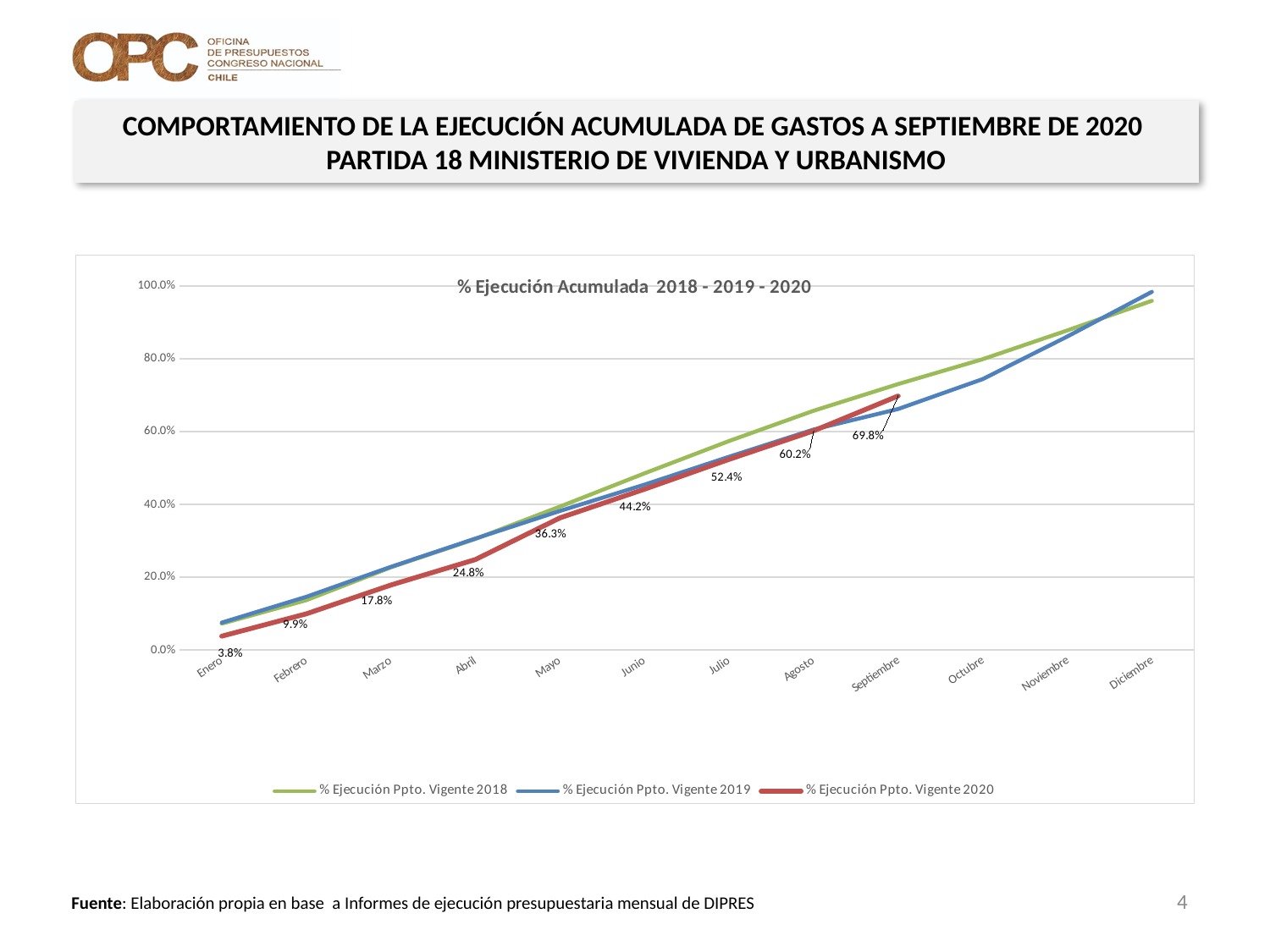
How many series does the legend list? 3 How many months are shown on the x axis? 12 What is the difference between the 2020 values for Septiembre and Agosto? 9.6% Is the value for % Ejecución Ppto. Vigente 2019 in Enero greater or less than 20%? less Do the values of the % Ejecución Ppto. Vigente 2020 series rise or fall from Enero to Septiembre? Rise What is the value of % Ejecución Ppto. Vigente 2020 for Enero? 3.8% What is the value of % Ejecución Ppto. Vigente 2020 for Mayo? 36.3% What is the value of % Ejecución Ppto. Vigente 2020 for Septiembre? 69.8% What kind of chart is shown on the slide? Line chart What is the title of the chart? % Ejecución Acumulada 2018 - 2019 - 2020 Is the value for % Ejecución Ppto. Vigente 2019 in Diciembre greater or less than 80%? greater What is the difference between the 2020 values for Abril and Marzo? 7.0%